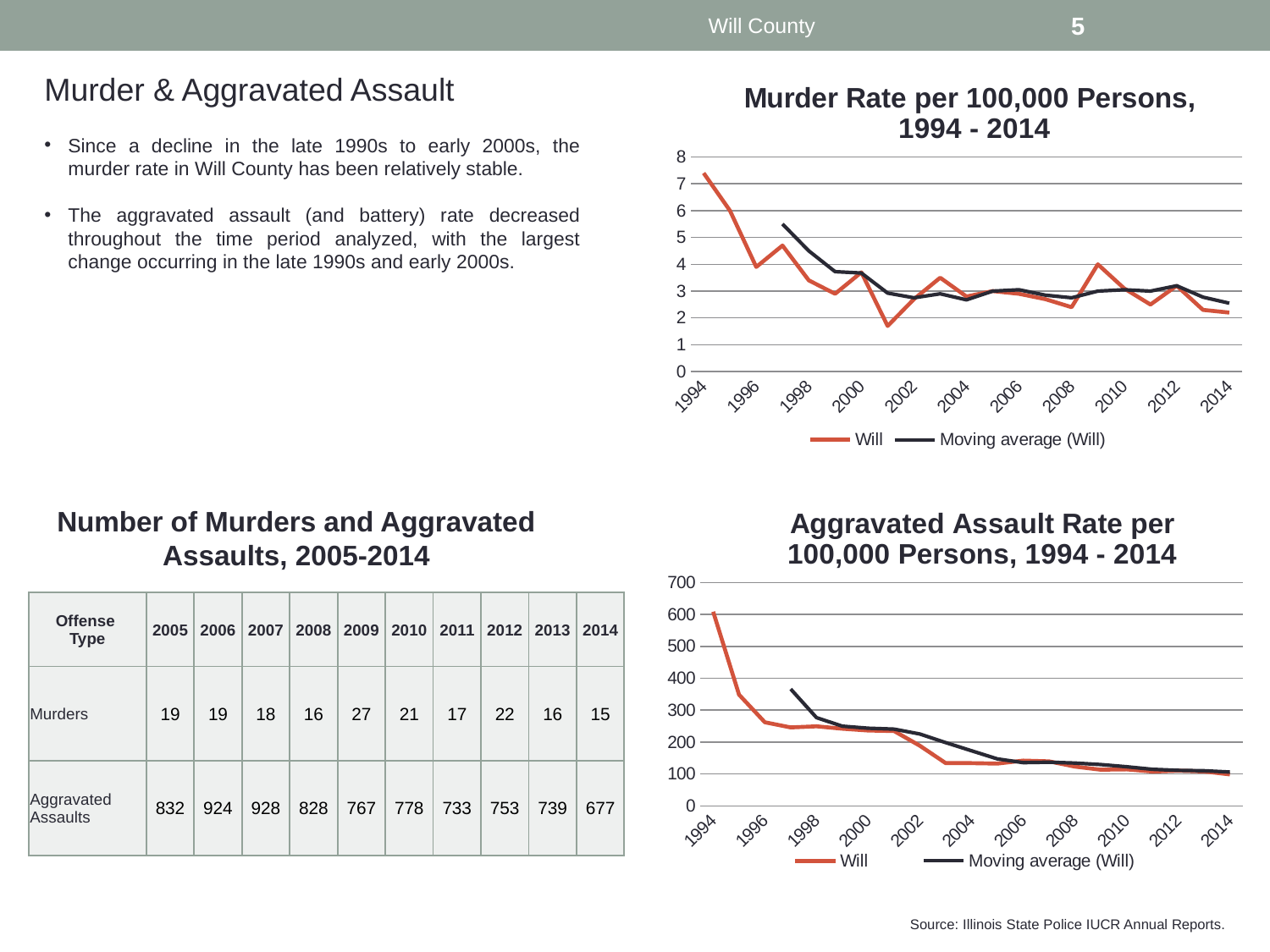
In the 'Aggravated Assault Rate per 100,000 Persons, 1994 - 2014' chart, does the Will series rise or fall from 1994 to 2014? Fall In the 'Aggravated Assault Rate per 100,000 Persons, 1994 - 2014' chart, is the Will value for 2014 greater or less than 200? less In the 'Murder Rate per 100,000 Persons, 1994 - 2014' chart, is the Will value for 1994 greater or less than 6? greater How many series does the legend of the 'Murder Rate per 100,000 Persons, 1994 - 2014' chart list? 2 What kind of chart is the 'Aggravated Assault Rate per 100,000 Persons, 1994 - 2014' chart? Line chart How many year labels are shown on the x axis of the 'Aggravated Assault Rate per 100,000 Persons, 1994 - 2014' chart? 11 In the 'Murder Rate per 100,000 Persons, 1994 - 2014' chart, does the Will series overall rise or fall from 1994 to 2014? Fall In the 'Murder Rate per 100,000 Persons, 1994 - 2014' chart, is the Will value for 2009 greater or less than 3? greater What kind of chart is the 'Murder Rate per 100,000 Persons, 1994 - 2014' chart? Line chart What are the two legend entries in the 'Murder Rate per 100,000 Persons, 1994 - 2014' chart? Will; Moving average (Will)